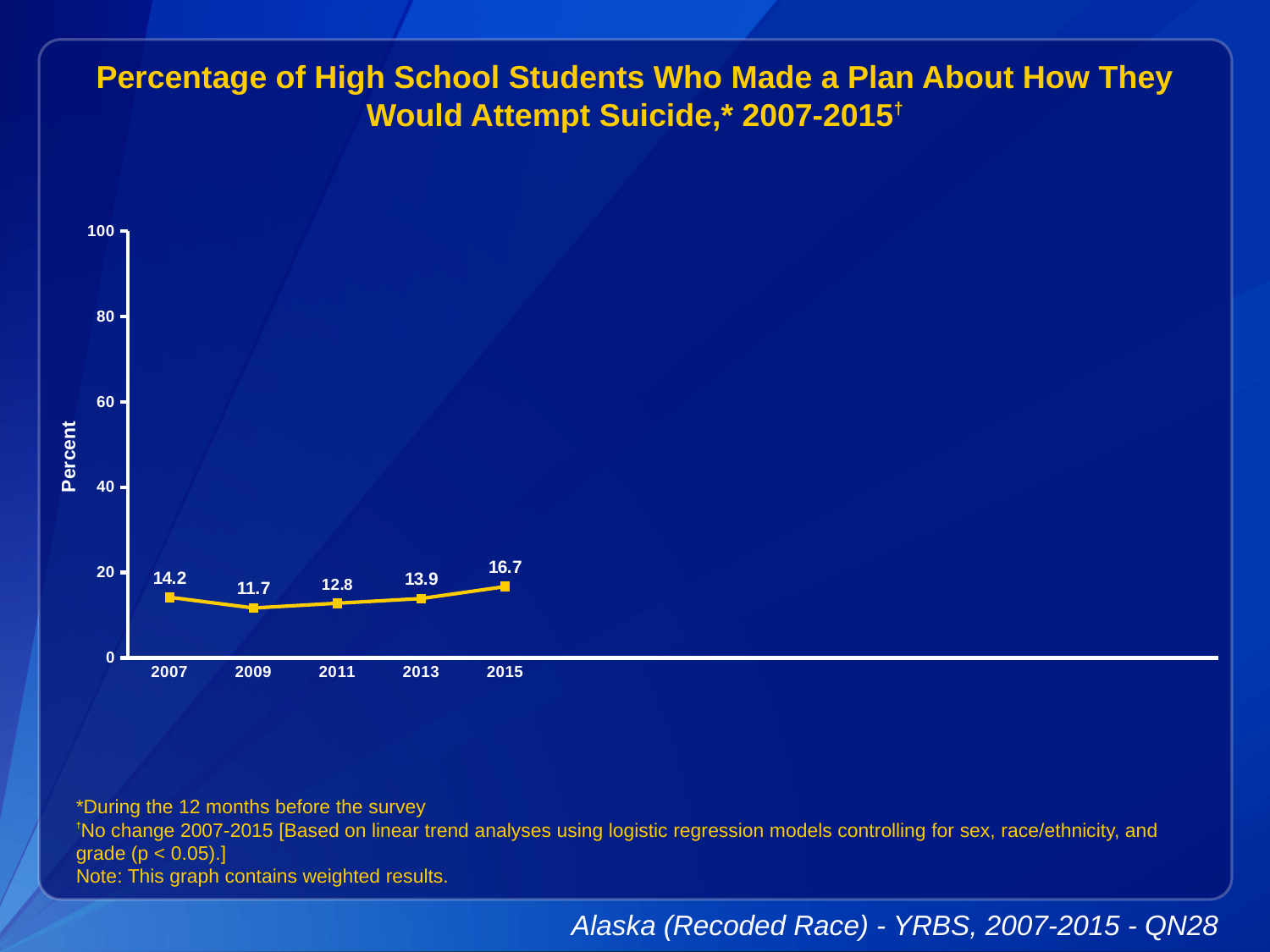
What is the label on the y axis? Percent How many years are plotted on the chart? 5 What is the value for 2011? 12.8 Do the values rise or fall from 2009 to 2015? rise What is the value for 2007? 14.2 What is the value for 2015? 16.7 Is the value for 2015 greater or less than 20? less Which year has the highest value? 2015 What kind of chart is shown? line chart Which year has the lowest value? 2009 What is the difference between the values for 2015 and 2009? 5.0 Which is larger, the value for 2007 or the value for 2013? 2007